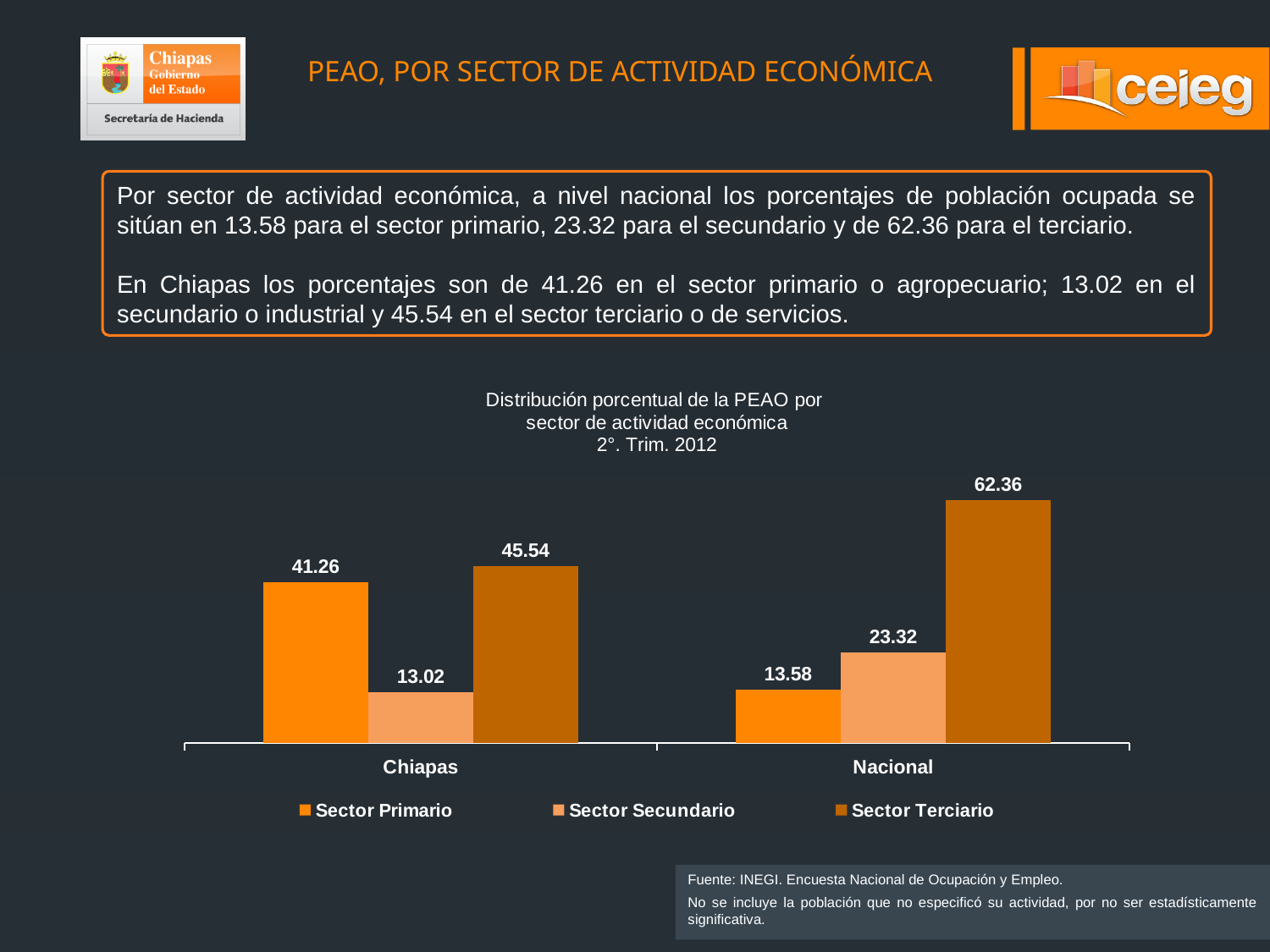
What kind of chart is shown on the slide? Bar chart What is the value for Sector Secundario in Nacional? 23.32 What is the value for Sector Primario in Chiapas? 41.26 How many series does the legend list? 3 Which is larger: Sector Primario in Chiapas or Sector Primario in Nacional? Chiapas What is the value for Sector Primario in Nacional? 13.58 Which sector has the highest value in Nacional? Sector Terciario What is the value for Sector Terciario in Chiapas? 45.54 What is the title of the chart? Distribución porcentual de la PEAO por sector de actividad económica 2°. Trim. 2012 How many categories are shown on the x axis? 2 What is the difference between the Sector Terciario values for Nacional and Chiapas? 16.82 Which sector has the lowest value in Chiapas? Sector Secundario